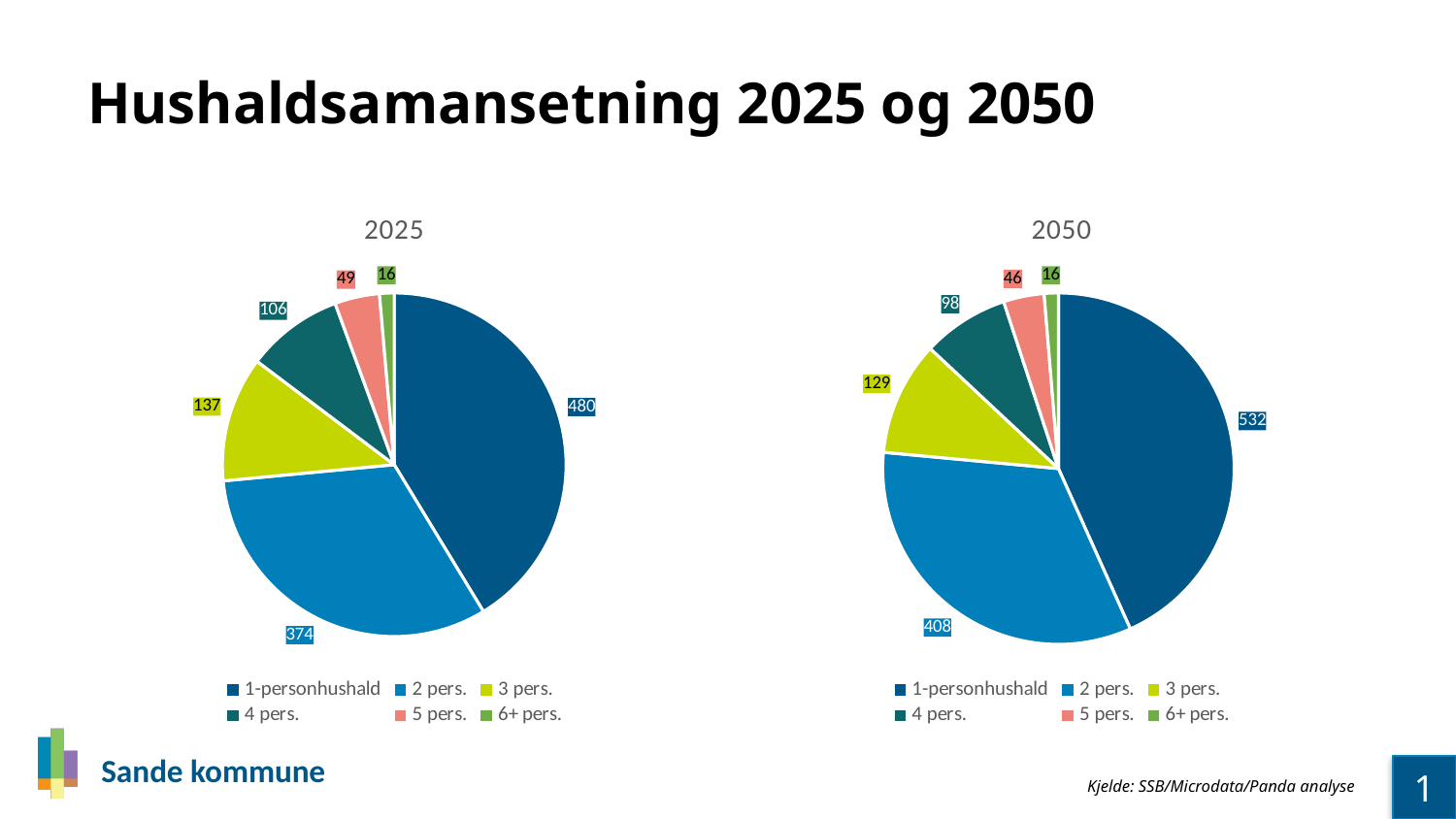
In the 2050 pie chart, what is the value for 4 pers.? 98 In the 2025 pie chart, what share of the total does the 1-personhushald slice represent? 41.3% How many slices does the 2025 pie chart have? 6 In the 2025 pie chart, which category has the largest slice? 1-personhushald What is the title of the slide? Hushaldsamansetning 2025 og 2050 In the 2050 pie chart, what is the difference between the values for 3 pers. and 4 pers.? 31 What type of chart is used for the 2050 data? Pie chart In the 2050 pie chart, which category has the smallest slice? 6+ pers. In the 2050 pie chart, what is the value for 1-personhushald? 532 In the 2025 pie chart, what is the value for 2 pers.? 374 In the 2025 pie chart, what is the difference between the values for 1-personhushald and 2 pers.? 106 Which is larger: the value for 3 pers. in the 2025 chart or the value for 3 pers. in the 2050 chart? 2025